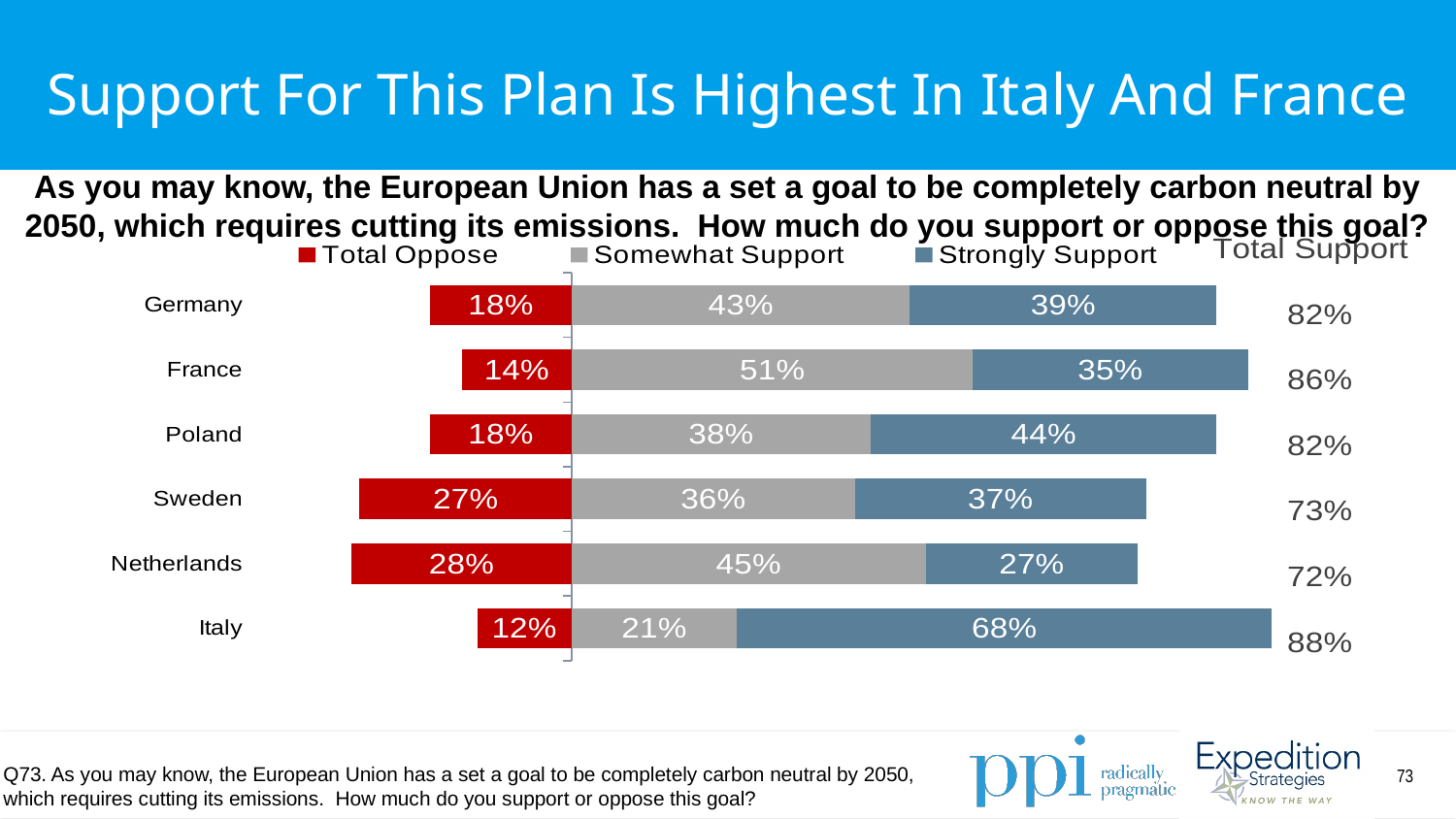
How many countries are shown in the chart? 6 Which country has the lowest Total Oppose percentage? Italy Which country has the highest Strongly Support percentage? Italy How many series does the legend list? 3 What is the difference between the Total Support figures for Italy and the Netherlands? 16% What is the Somewhat Support value for France? 51% What is the Total Oppose value for the Netherlands? 28% What kind of chart is shown on the slide? Stacked bar chart What is the total of Somewhat Support and Strongly Support for Sweden? 73% Which is larger, the Strongly Support value for Poland or for Germany? Poland Which country has the highest Total Support figure? Italy What percentage of respondents in Italy strongly support the goal? 68%